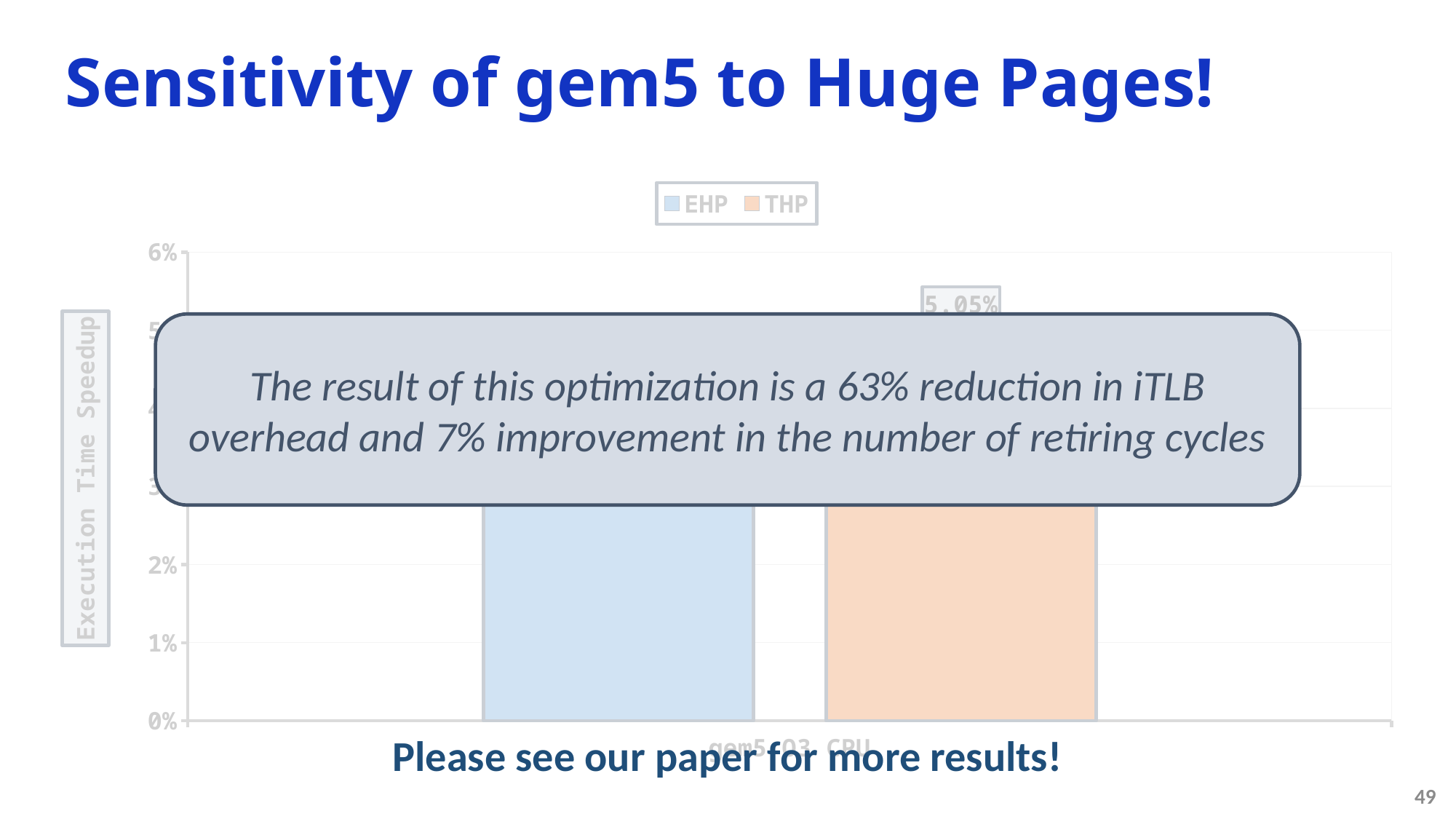
What are the two series named in the legend? EHP and THP What is the title of the vertical axis? Execution Time Speedup How many series does the legend list? 2 What is the execution time speedup value labelled on the THP bar? 5.05% Is the value for EHP greater or less than 2%? greater Is the value for EHP greater or less than 1%? greater What kind of chart is shown on the slide? bar chart Is the value for THP greater or less than 6%? less How many categories are plotted on the x axis? 1